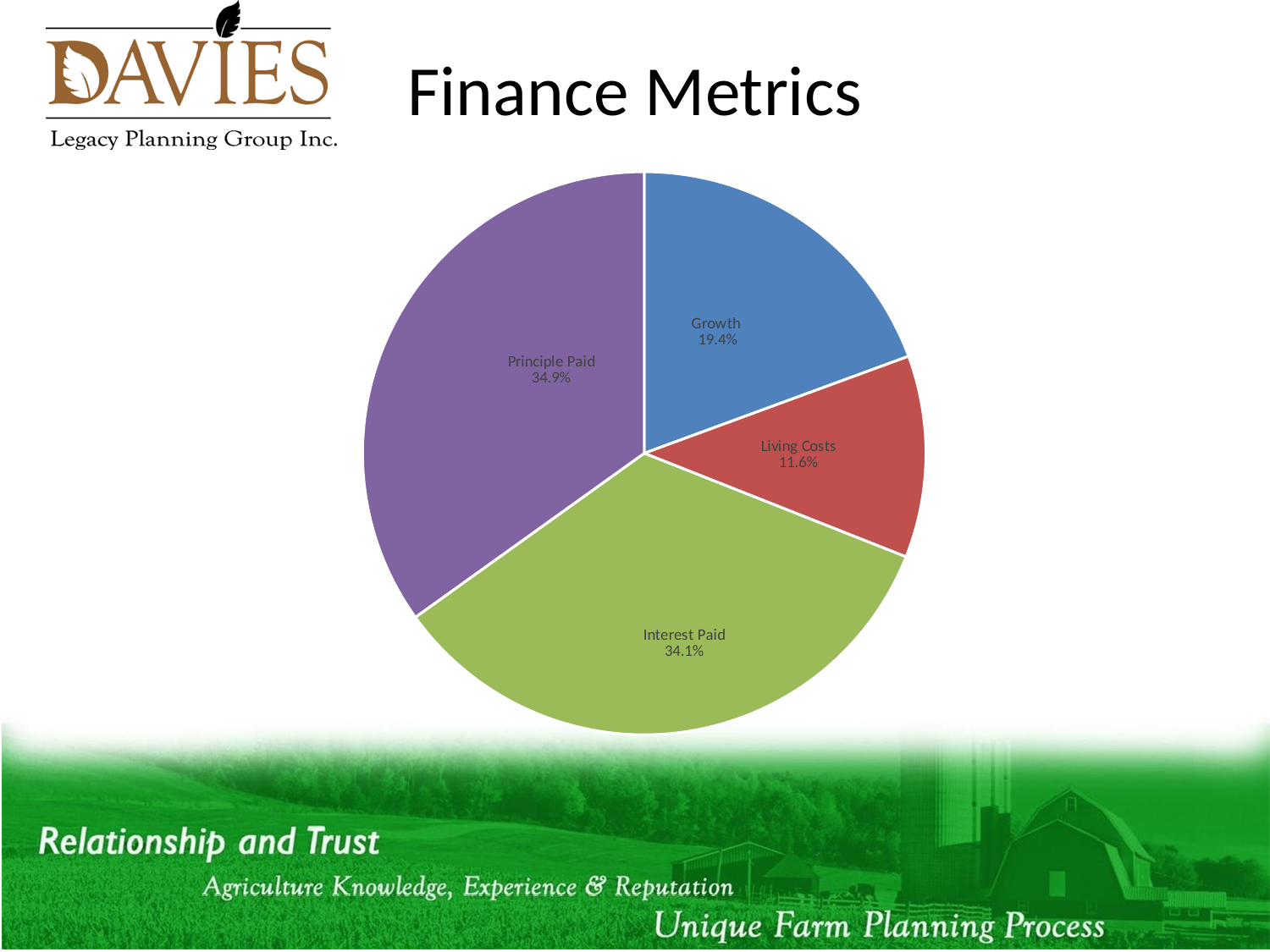
Which is larger, Growth or Living Costs? Growth What is the difference in percentage points between Growth and Living Costs? 7.8 How many slices does the pie chart have? 4 What colour is the Interest Paid slice? green What kind of chart is shown on the slide? pie chart What is the value shown for Interest Paid? 34.1% What is the value shown for Living Costs? 11.6% What is the difference in percentage points between Principle Paid and Interest Paid? 0.8 Which slice of the pie is the largest? Principle Paid What is the value shown for Principle Paid? 34.9% What share of the pie does Growth represent? 19.4% Which slice of the pie is the smallest? Living Costs